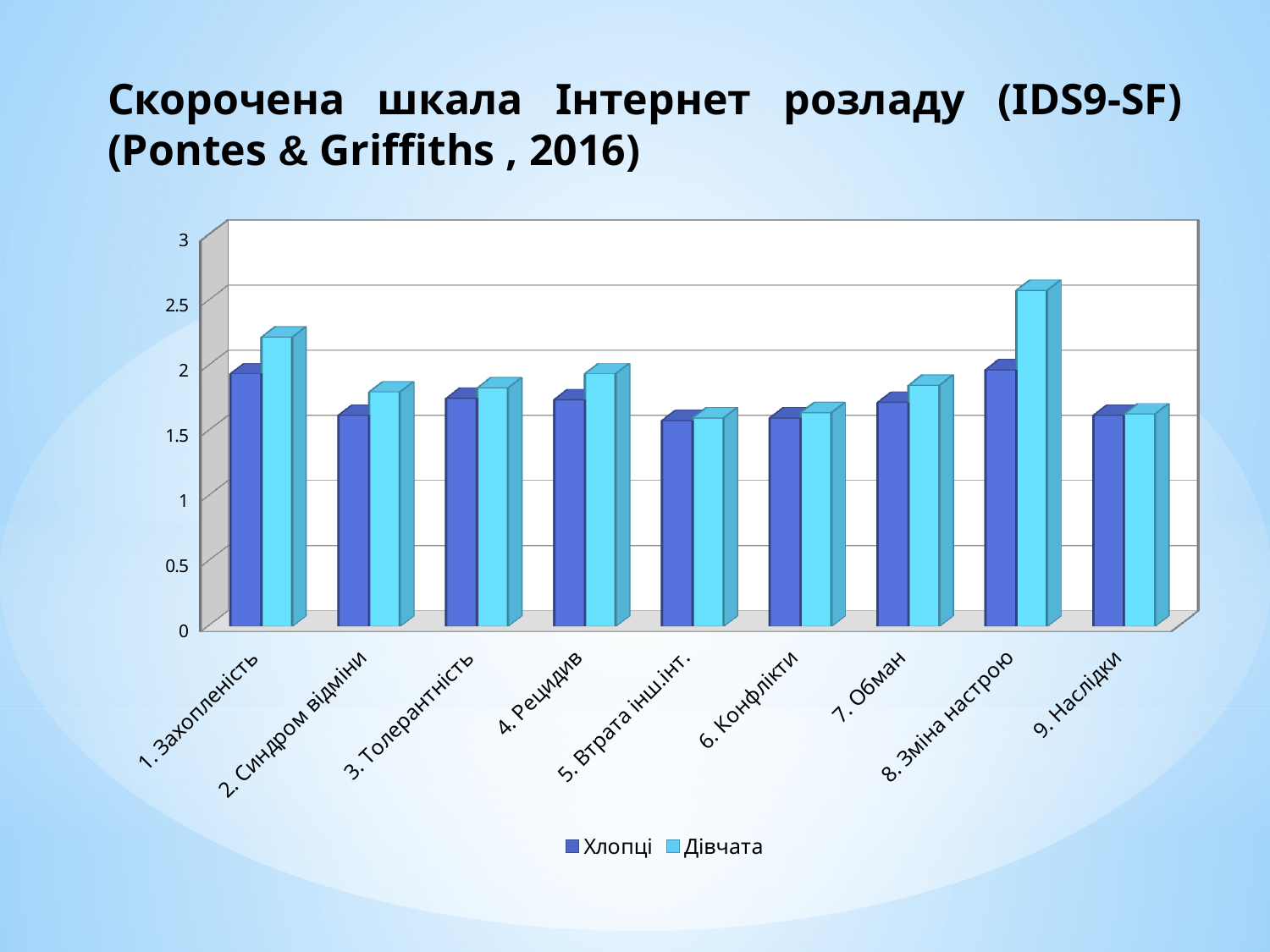
Is the Дівчата value for 1. Захопленість greater or less than 2? greater Is the Дівчата value for 8. Зміна настрою greater or less than 2? greater How many series does the chart legend list? 2 For the category 1. Захопленість, which series has the larger value, Хлопці or Дівчата? Дівчата What are the two series named in the chart legend? Хлопці and Дівчата Is the Хлопці value for 5. Втрата інш.інт. greater or less than 2? less Which series is drawn in light blue in the chart? Дівчата Which category has the highest value for the Дівчата series? 8. Зміна настрою How many categories are shown on the x axis of the chart? 9 What kind of chart is shown on the slide? bar chart For the category 8. Зміна настрою, which series has the larger value, Хлопці or Дівчата? Дівчата